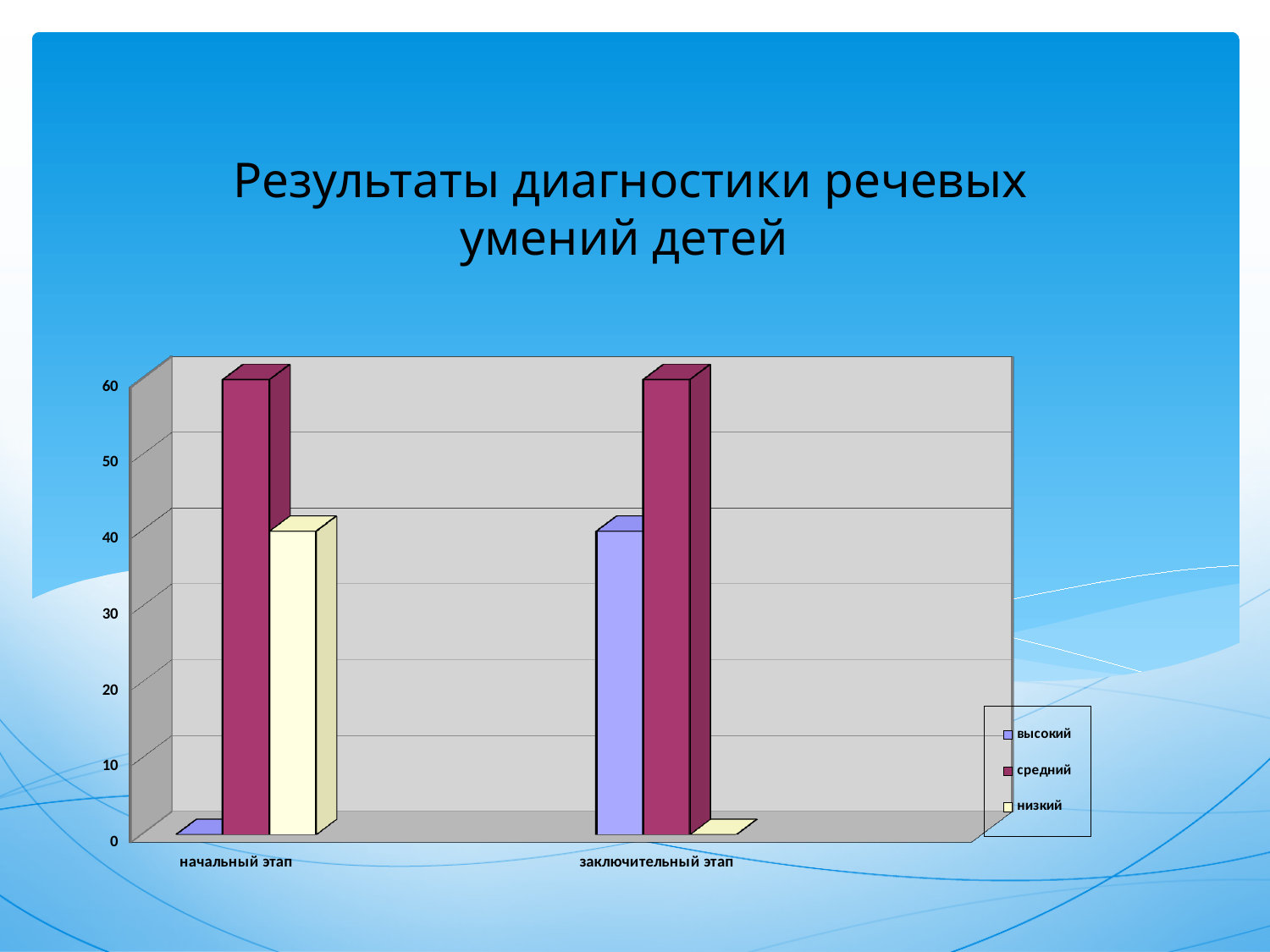
What is the value for низкий at начальный этап? 40 How many categories are shown on the x axis? 2 Which series has the lowest value at заключительный этап? низкий What kind of chart is shown on the slide? bar chart Does the value for низкий rise or fall from начальный этап to заключительный этап? fall What is the value for средний at начальный этап? 60 What is the value for высокий at заключительный этап? 40 How many series does the legend list? 3 Which series has the highest value at начальный этап? средний What is the title of the chart on the slide? Результаты диагностики речевых умений детей Which stage has the larger value for высокий: начальный этап or заключительный этап? заключительный этап Is the value for средний at заключительный этап greater or less than 50? greater